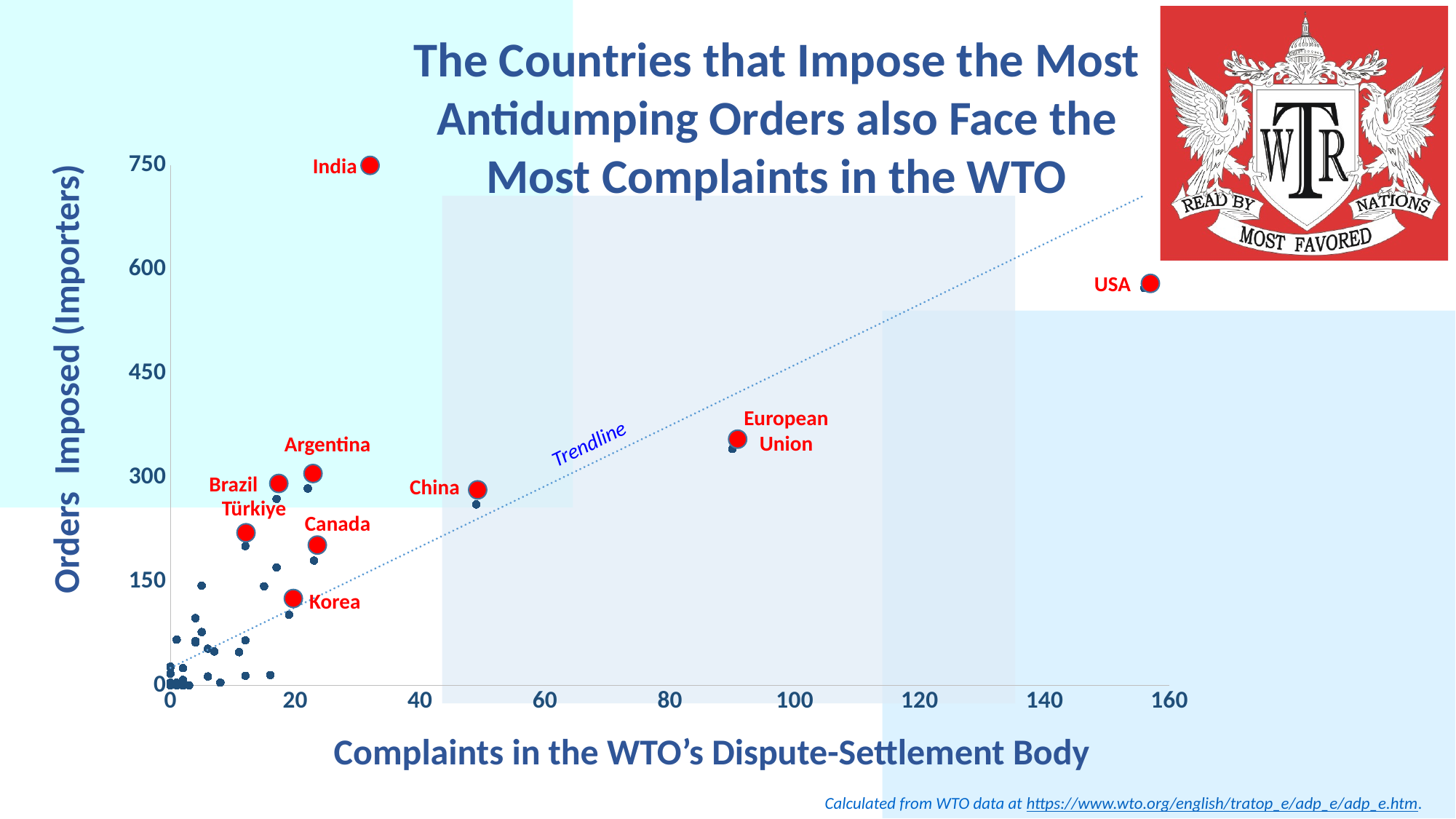
Is the number of complaints for the European Union greater or less than 100? less What is the label on the horizontal axis of the chart? Complaints in the WTO's Dispute-Settlement Body Which labeled country has the most complaints in the WTO's Dispute-Settlement Body? USA How many countries are labeled with red markers on the chart? 9 Is the number of orders imposed by Korea greater or less than 150? less Is the number of orders imposed by India greater or less than 600? greater Which labeled country has the highest number of orders imposed? India Which labeled country has the lowest number of orders imposed? Korea What kind of chart is shown on the slide? scatter chart Which has more complaints in the WTO's Dispute-Settlement Body, China or Korea? China Which has more orders imposed, Canada or Korea? Canada